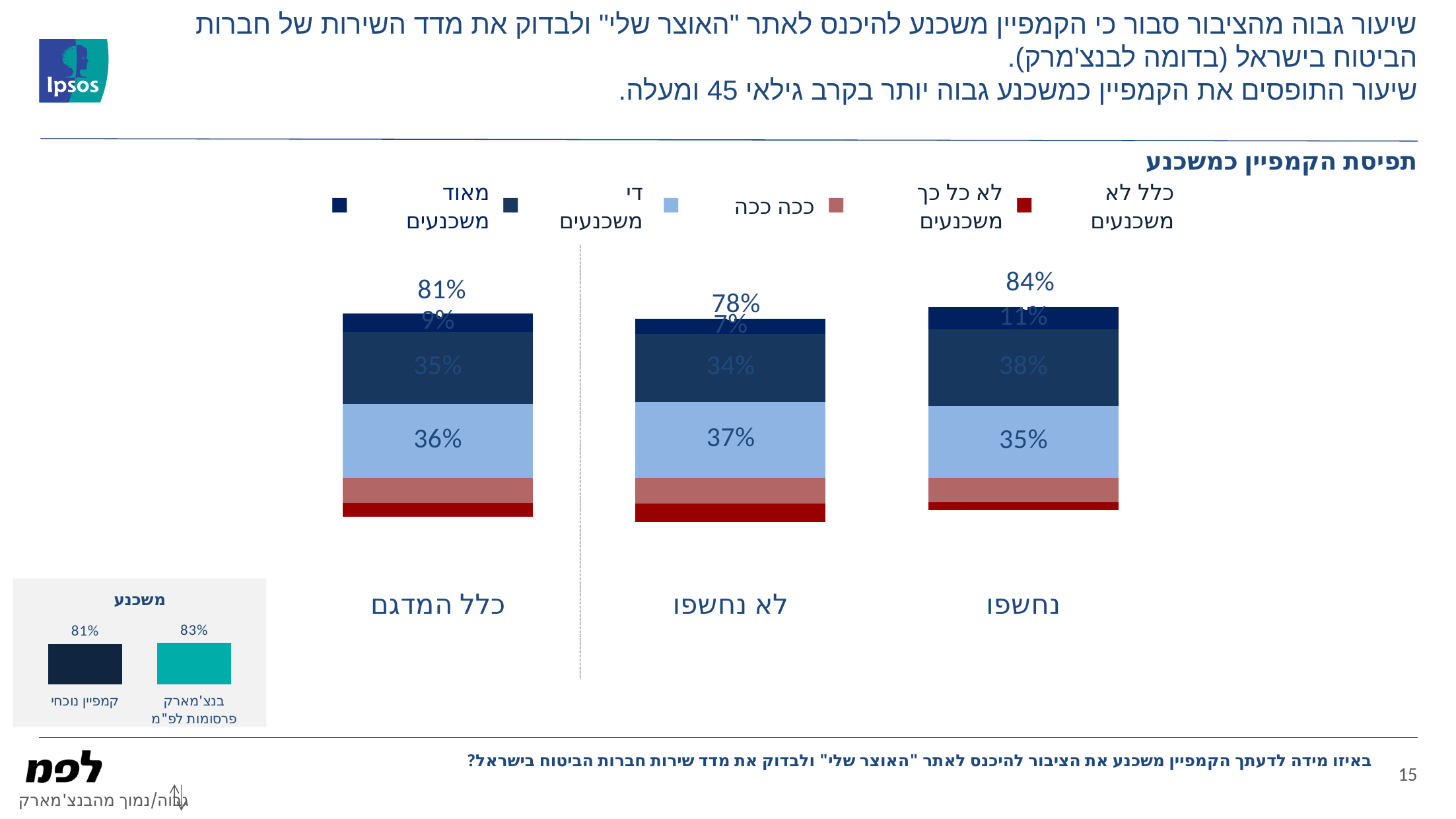
How many series does the chart legend list? 5 How many categories (bars) does the chart show? 3 What is the value of the 'די משכנעים' segment for 'כלל המדגם'? 35% What is the difference between the percentages printed above the bars for 'נחשפו' and 'לא נחשפו'? 6 percentage points What is the value of the 'מאוד משכנעים' segment for 'נחשפו'? 11% What kind of chart is shown on the slide? bar chart What is the value of the 'די משכנעים' segment for 'נחשפו'? 38% What is the title of the chart? תפיסת הקמפיין כמשכנע Which category has the lowest percentage printed above its bar? לא נחשפו What percentage is printed above the bar for 'לא נחשפו'? 78% What is the value of the 'די משכנעים' segment for 'לא נחשפו'? 34% Which category has the highest percentage printed above its bar? נחשפו